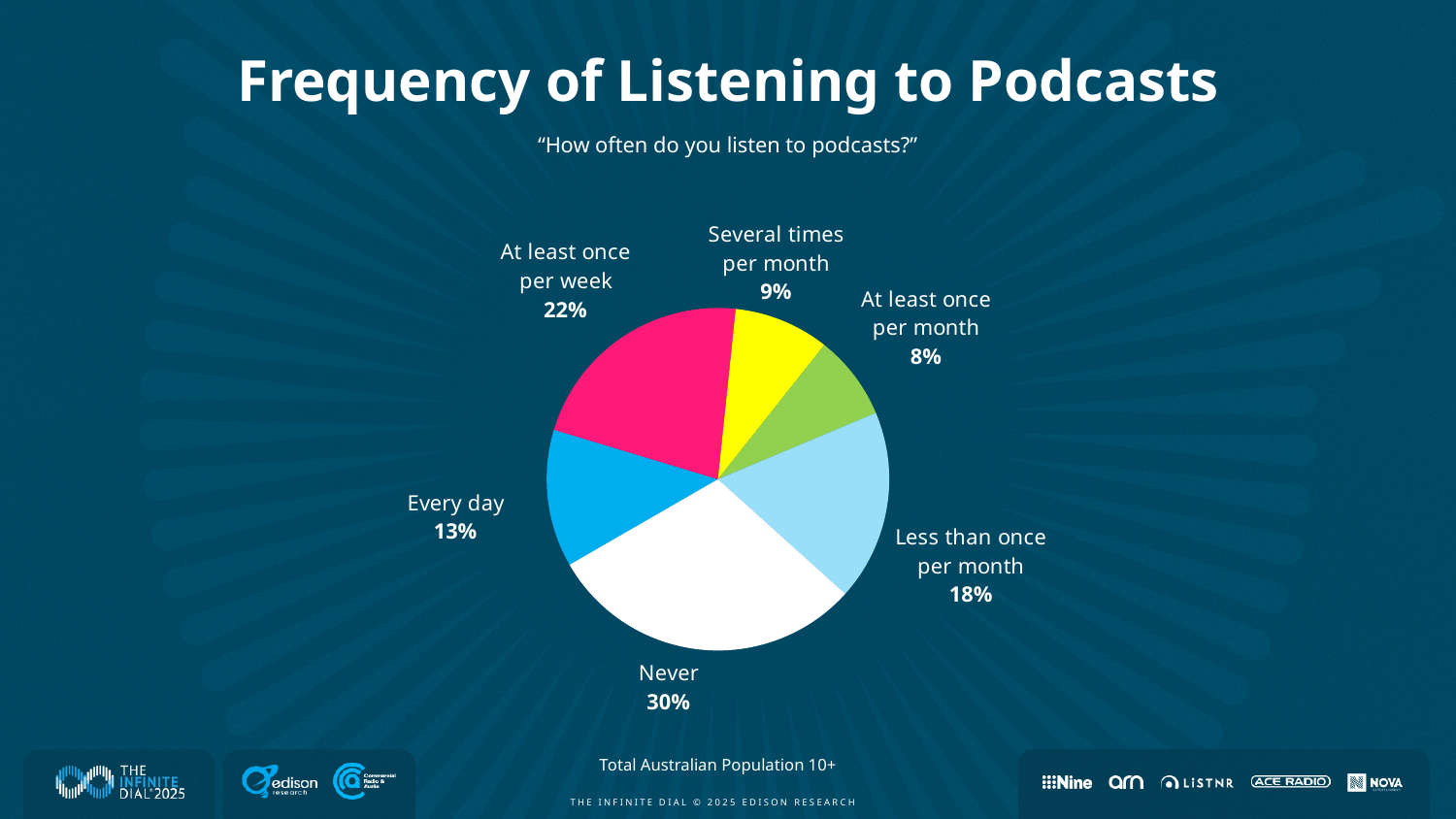
What is the title of the chart on the slide? Frequency of Listening to Podcasts What percentage of respondents say they listen to podcasts every day? 13% Which is larger: the share for 'Several times per month' or the share for 'At least once per month'? Several times per month What percentage of respondents listen to podcasts at least once per week? 22% How many categories are shown in the pie chart? 6 What is the combined percentage of respondents who listen at least once per week or every day? 35% What type of chart is shown on the slide? Pie chart What percentage of respondents listen to podcasts less than once per month? 18% Which listening frequency category has the largest share of the pie? Never Which listening frequency category has the smallest share of the pie? At least once per month What percentage of respondents say they never listen to podcasts? 30% What is the difference in percentage points between 'Never' and 'Every day'? 17